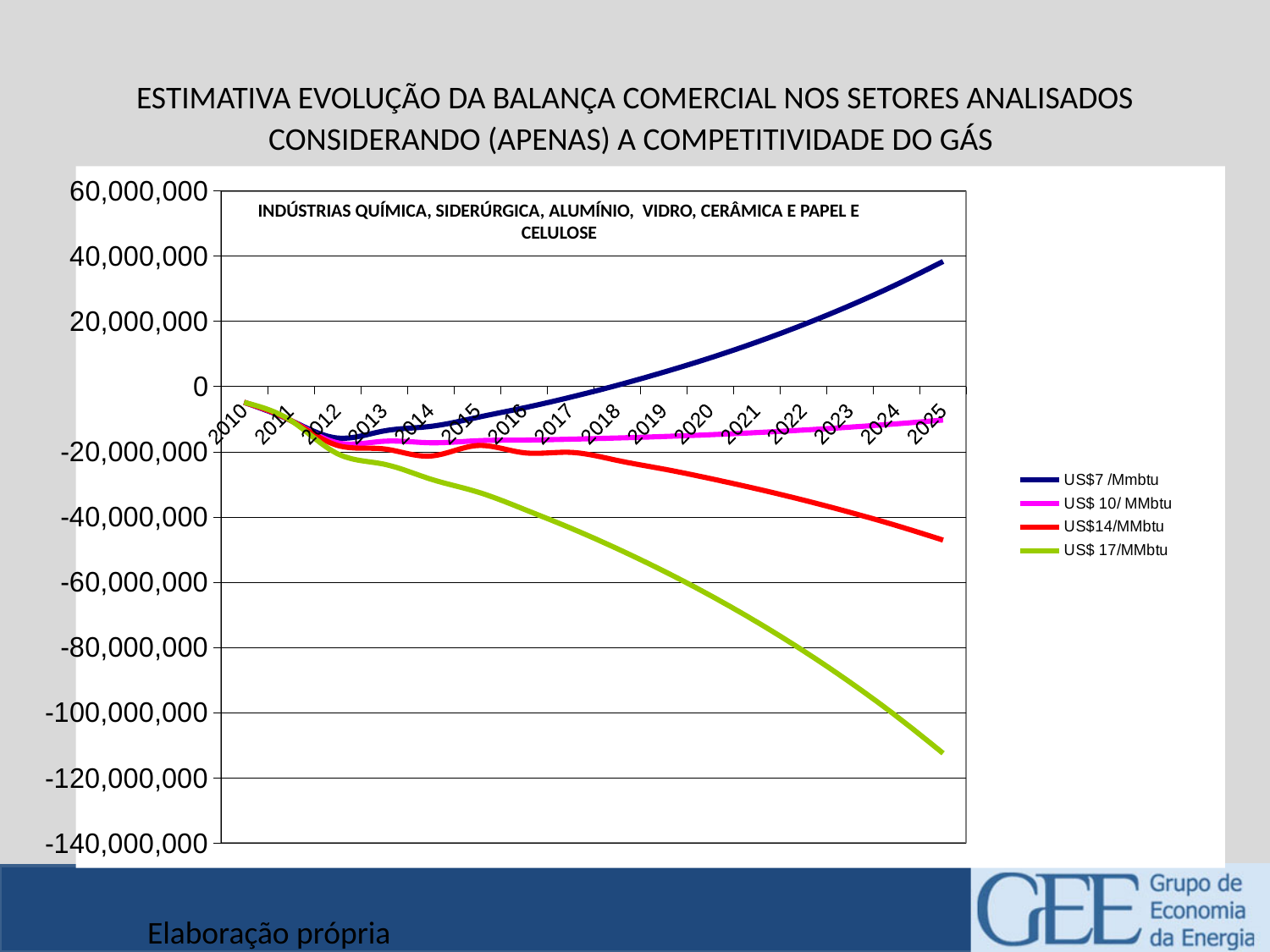
How many years are shown along the x axis? 16 What colour is the line for US$ 17/MMbtu? Green Which series has the highest value in 2025? US$7 /Mmbtu Is the value for US$14/MMbtu in 2025 greater or less than -40,000,000? less Is the value for US$ 17/MMbtu in 2025 greater or less than -100,000,000? less Which series has the lowest value in 2025? US$ 17/MMbtu In 2025, which is larger: the value for US$7 /Mmbtu or the value for US$ 17/MMbtu? US$7 /Mmbtu Is the value for US$7 /Mmbtu in 2025 greater or less than 20,000,000? greater What kind of chart is shown on the slide? Line chart Does the US$7 /Mmbtu series rise or fall from 2015 to 2025? Rise How many series does the legend list? 4 Does the US$ 17/MMbtu series rise or fall from 2010 to 2025? Fall